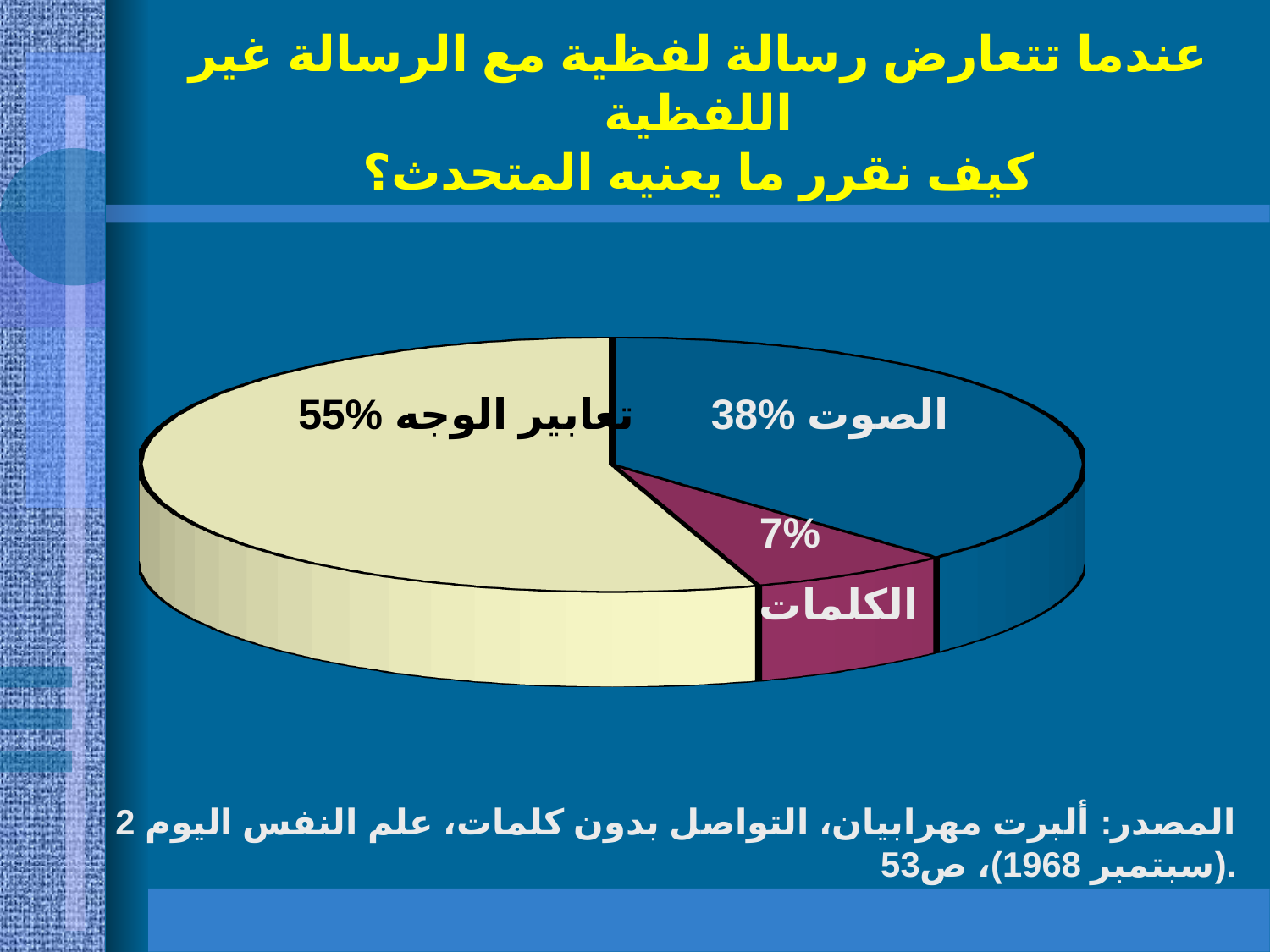
Which is larger, the slice for الصوت or the slice for الكلمات? الصوت What percentage is shown for الكلمات (words)? 7% What percentage is shown for الصوت (voice)? 38% Which slice of the pie chart is the largest? تعابير الوجه (55%) What is the combined share of الصوت and الكلمات? 45% What kind of chart is shown on the slide? pie chart What is the difference in percentage points between تعابير الوجه and الصوت? 17 What colour is the slice for الكلمات? purple (magenta) Which slice of the pie chart is the smallest? الكلمات (7%) What is the difference in percentage points between الصوت and الكلمات? 31 What percentage is shown for تعابير الوجه (facial expressions)? 55% How many slices does the pie chart have? 3